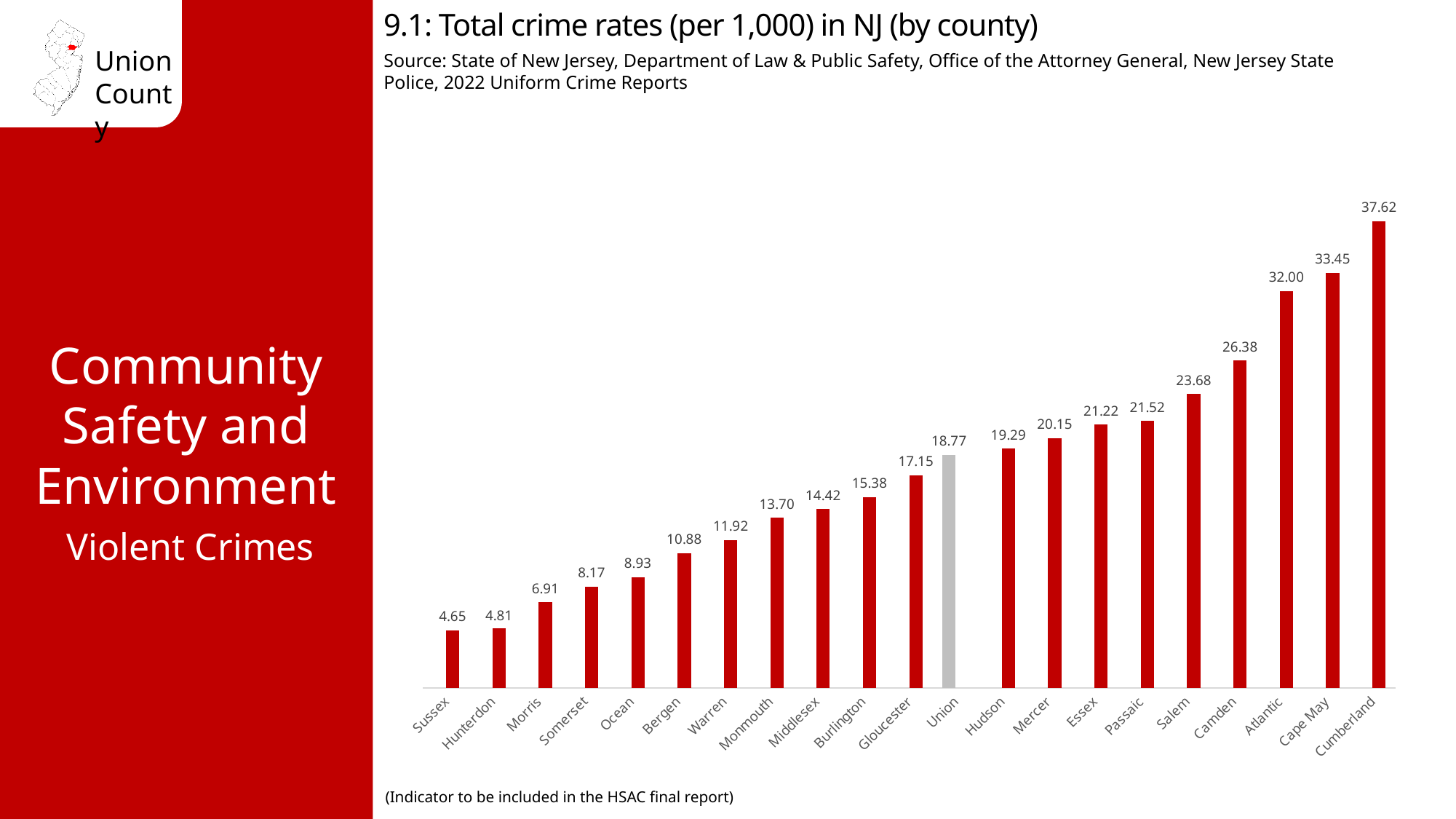
What is the total crime rate per 1,000 for Union county? 18.77 What is the total crime rate per 1,000 for Bergen county? 10.88 What is the total crime rate per 1,000 for Camden county? 26.38 Which county has the highest total crime rate? Cumberland Which county has a higher crime rate, Atlantic or Cape May? Cape May How many counties are shown in the chart? 21 Which county has the lowest total crime rate? Sussex What kind of chart is shown on the slide? Bar chart Which county's bar is shown in grey rather than red? Union What is the difference between the crime rates of Union and Gloucester? 1.62 What is the difference between the crime rates of Cumberland and Sussex? 32.97 Which county has a higher crime rate, Morris or Ocean? Ocean